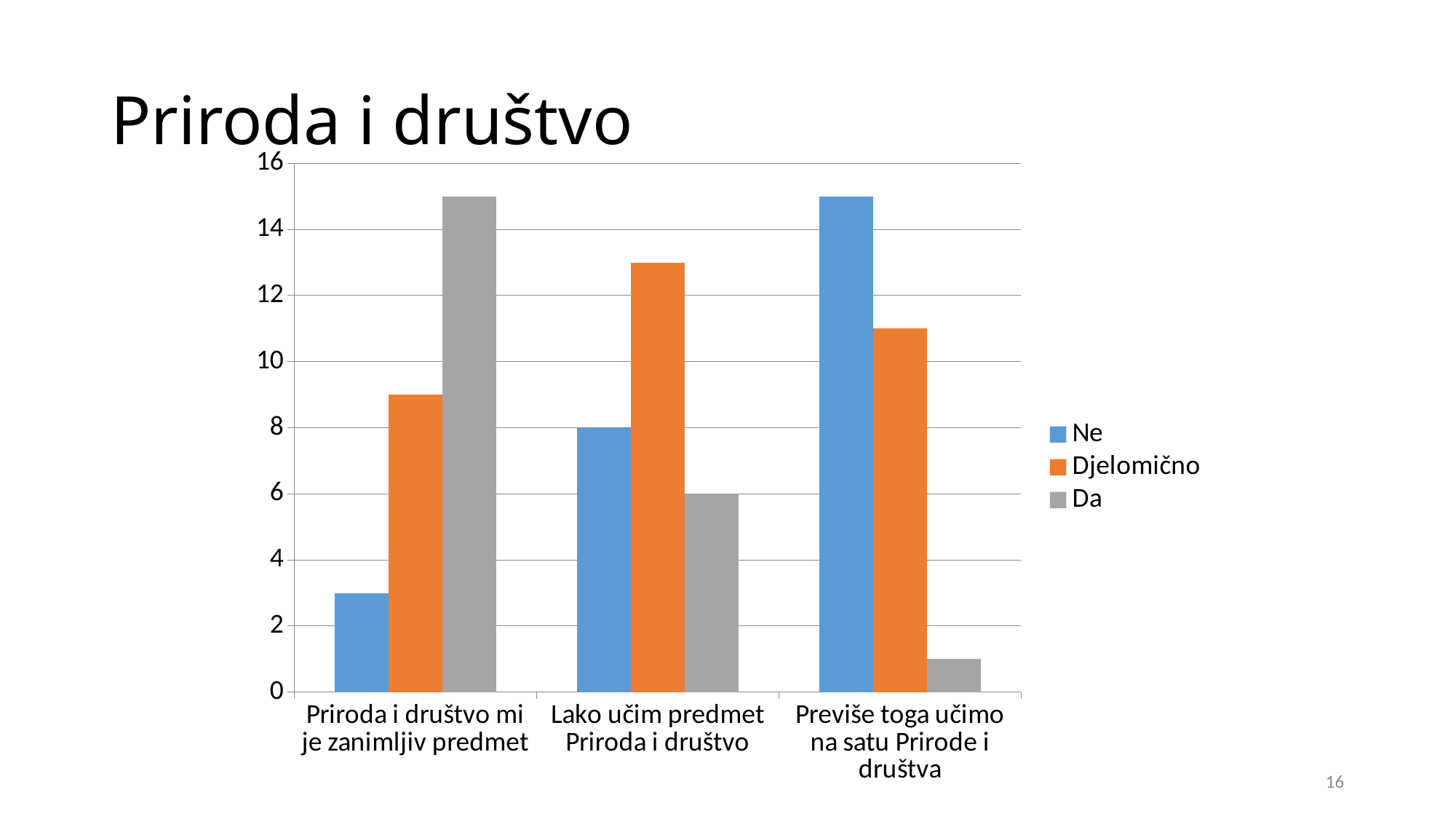
Is the value for Da in the category 'Priroda i društvo mi je zanimljiv predmet' greater or less than 14? greater Which is larger in the category 'Lako učim predmet Priroda i društvo': Djelomično or Ne? Djelomično What is the title of the slide? Priroda i društvo What is the value for Ne in the category 'Lako učim predmet Priroda i društvo'? 8 How many series does the legend list? 3 Which series has the highest value in the category 'Priroda i društvo mi je zanimljiv predmet'? Da What is the value for Da in the category 'Lako učim predmet Priroda i društvo'? 6 Is the value for Ne in the category 'Priroda i društvo mi je zanimljiv predmet' greater or less than 4? less In which category is the Ne series highest? Previše toga učimo na satu Prirode i društva Which series has the lowest value in the category 'Previše toga učimo na satu Prirode i društva'? Da How many categories are shown on the x axis? 3 What type of chart is shown on the slide? bar chart